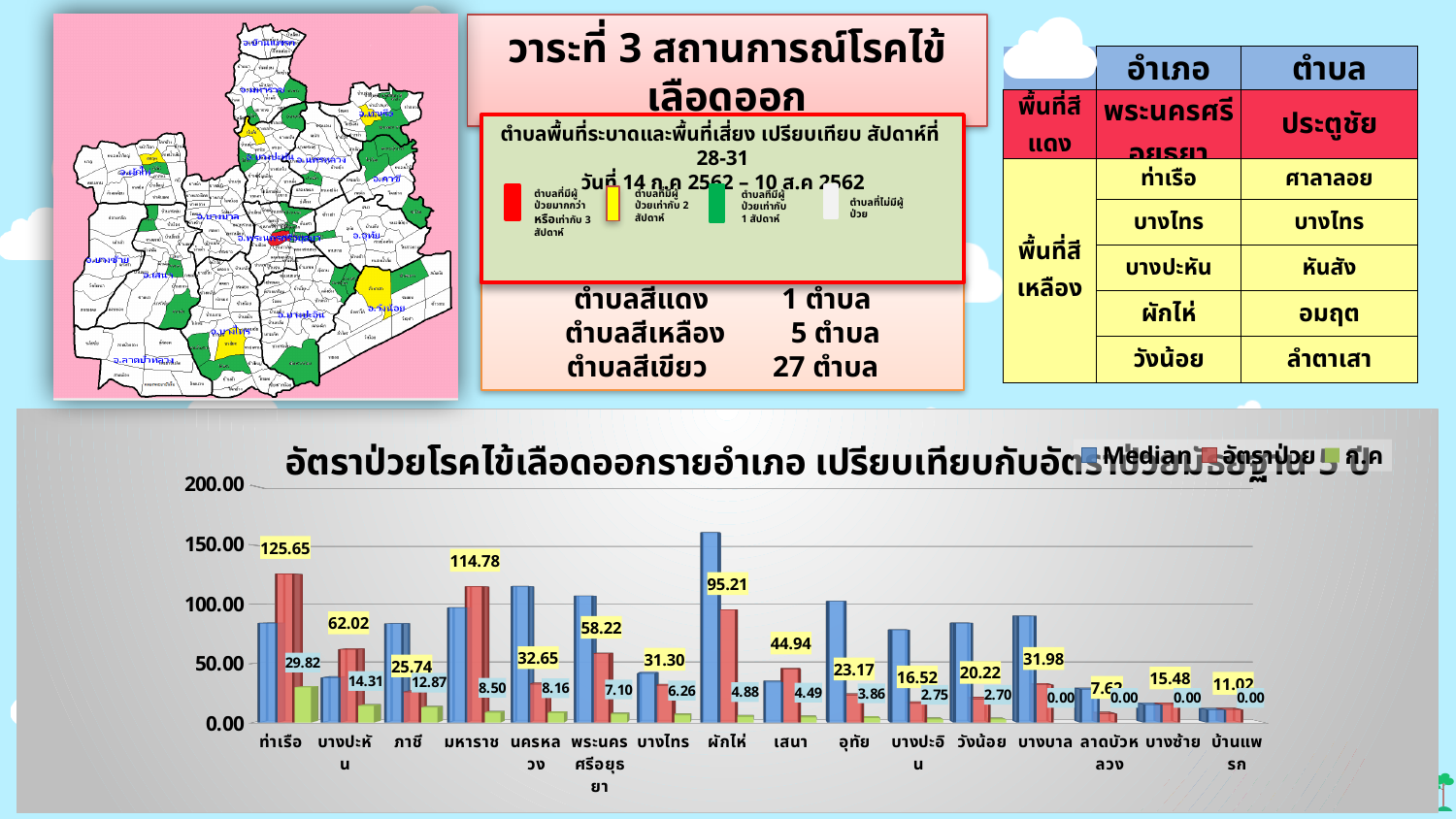
In the bar chart, what is the difference between the อัตราป่วย value and the ก.ค value for ท่าเรือ? 95.83 How many districts (categories) are shown on the x axis of the bar chart? 16 Which district has the highest อัตราป่วย value in the bar chart? ท่าเรือ How many series does the legend of the bar chart list? 3 In the bar chart, which district has the larger อัตราป่วย value, มหาราช or ผักไห่? มหาราช Do the ก.ค values in the bar chart generally rise or fall from left to right along the x axis? fall What is the ก.ค value for ท่าเรือ in the bar chart? 29.82 What kind of chart is shown at the bottom of the slide? bar chart What is the ก.ค value for บางบาล in the bar chart? 0.00 Which district has the lowest อัตราป่วย value in the bar chart? ลาดบัวหลวง What is the อัตราป่วย value for ท่าเรือ in the bar chart? 125.65 Is the Median value for ผักไห่ in the bar chart greater or less than 150.00? greater